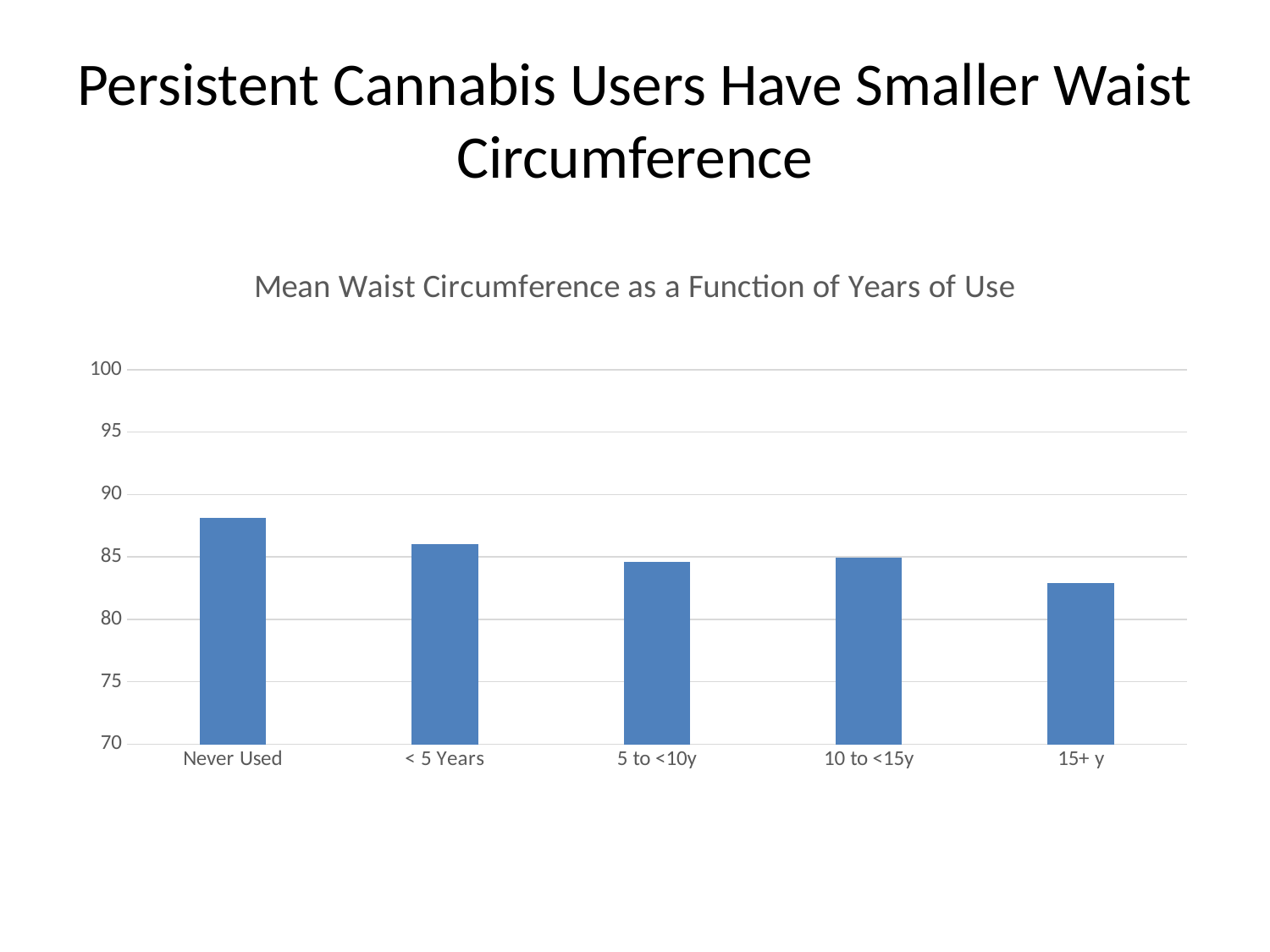
What is the title of the chart? Mean Waist Circumference as a Function of Years of Use How many categories are shown on the x axis of the chart? 5 What kind of chart is shown on the slide? Bar chart Is the value for 15+ y greater or less than 85? less Is the value for Never Used greater or less than 85? greater Which category has the highest mean waist circumference? Never Used Is the value for 15+ y greater or less than 80? greater Which category has the lowest mean waist circumference? 15+ y Which is larger, the value for Never Used or the value for 15+ y? Never Used Which is larger, the value for Never Used or the value for < 5 Years? Never Used Overall, do the values rise or fall from Never Used to 15+ y along the x axis? fall